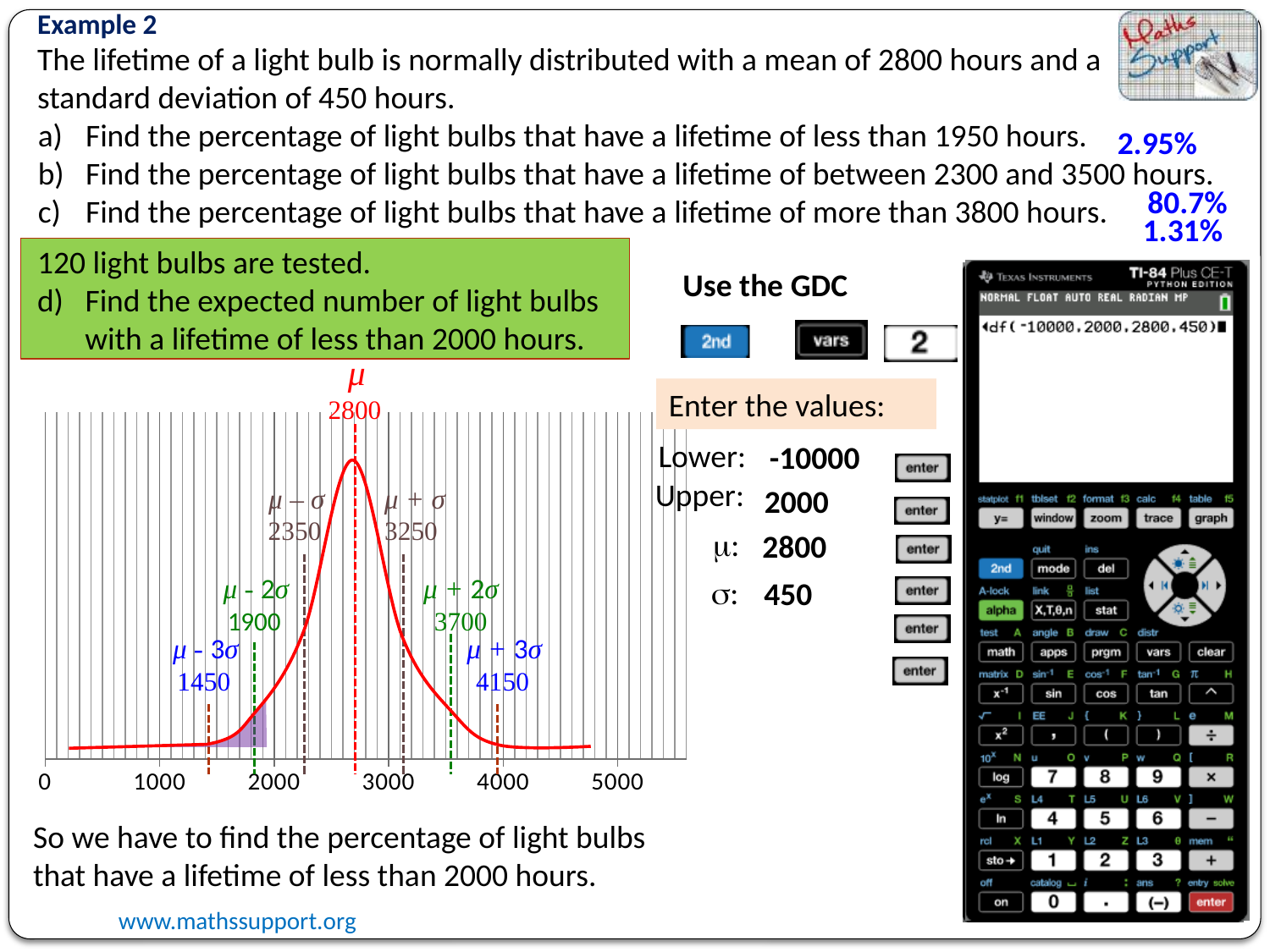
On the normal distribution chart, what value is labelled at μ − σ? 2350 On the normal distribution chart, what value is labelled at μ − 2σ? 1900 How many numeric tick labels are shown on the x axis of the normal distribution chart? 6 On the normal distribution chart, what is the difference between the values labelled at μ + σ and μ − σ? 900 On the normal distribution chart, at which labelled x value does the curve reach its peak? 2800 What is the largest tick label shown on the x axis of the normal distribution chart? 5000 On the normal distribution chart, what value is labelled at μ − 3σ? 1450 On the normal distribution chart, what value is labelled at μ + 3σ? 4150 On the normal distribution chart, what value is labelled at μ + σ? 3250 What colour is the normal distribution curve drawn in? Red On the normal distribution chart, what value is labelled at the mean μ? 2800 On the normal distribution chart, which labelled value is larger, μ + 2σ or μ + σ? μ + 2σ